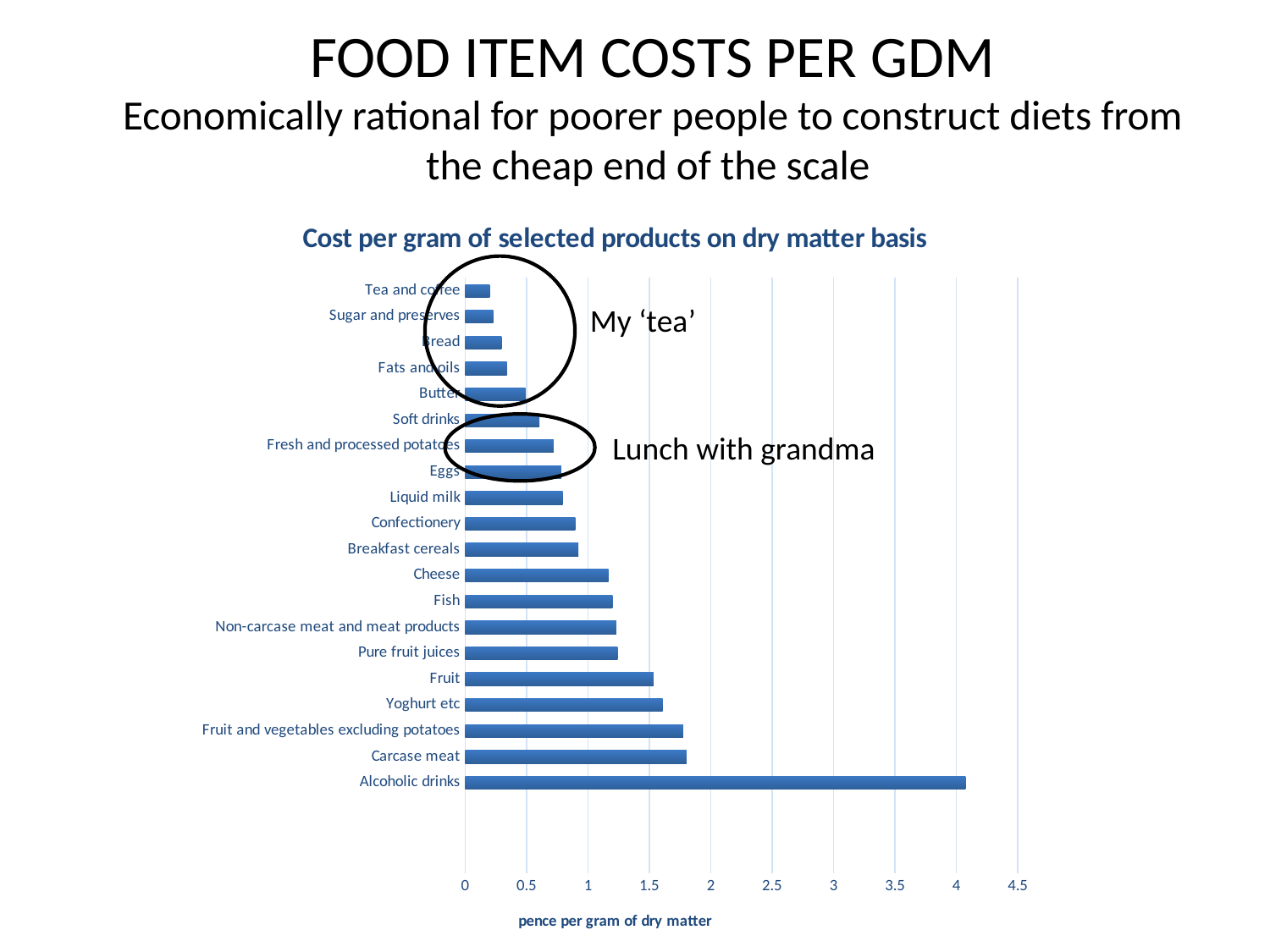
Is the value for Tea and coffee greater or less than 0.5? less What is the label on the horizontal axis of the chart? pence per gram of dry matter Is the value for Alcoholic drinks greater or less than 4? greater Do the bar values increase or decrease going from the top category to the bottom category? increase Is the value for Cheese greater or less than 1? greater What is the title of the chart? Cost per gram of selected products on dry matter basis Which has a higher cost per gram of dry matter, Alcoholic drinks or Carcase meat? Alcoholic drinks Which category has the highest cost per gram of dry matter? Alcoholic drinks How many food categories are plotted in the chart? 20 What type of chart is shown on the slide? Bar chart